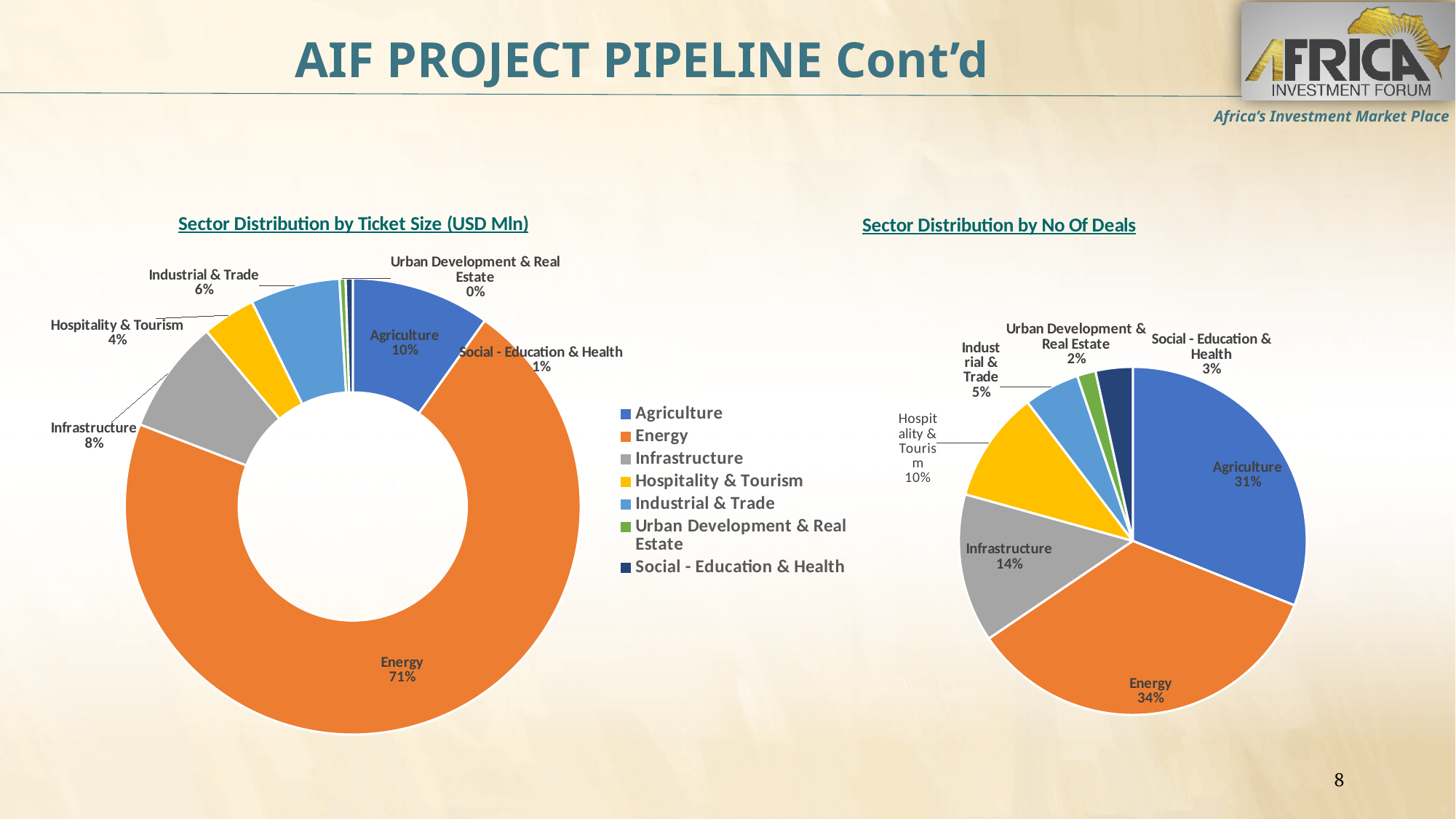
In the 'Sector Distribution by Ticket Size (USD Mln)' chart, what is the share for Infrastructure? 8% In the 'Sector Distribution by No Of Deals' chart, what share does Agriculture have? 31% In the 'Sector Distribution by No Of Deals' chart, which sector has the largest share? Energy In the 'Sector Distribution by No Of Deals' chart, what is the difference between the Energy and Agriculture shares? 3% In the 'Sector Distribution by Ticket Size (USD Mln)' chart, which sector has the largest share? Energy Which colour represents Energy in the legend? Orange What kind of chart is 'Sector Distribution by Ticket Size (USD Mln)'? Doughnut chart How many sectors does the legend list? 7 In the 'Sector Distribution by Ticket Size (USD Mln)' chart, what share does Agriculture have? 10% In the 'Sector Distribution by No Of Deals' chart, what is the share for Infrastructure? 14% In the 'Sector Distribution by Ticket Size (USD Mln)' chart, what share does Energy have? 71% In the 'Sector Distribution by No Of Deals' chart, which is larger: Hospitality & Tourism or Industrial & Trade? Hospitality & Tourism